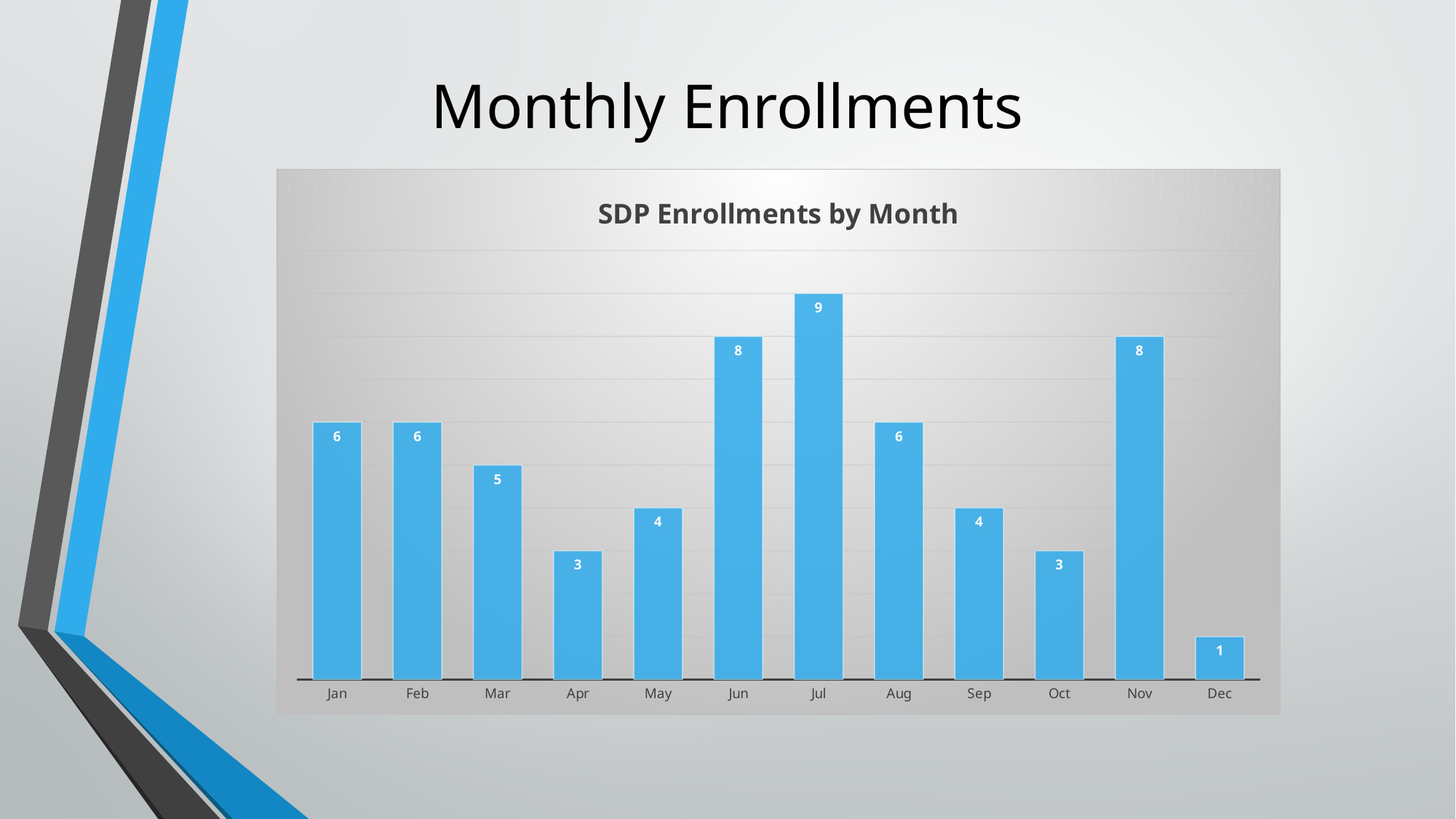
Which month has the lowest value? Dec How many months are shown on the x axis? 12 What is the difference between the values for Jul and Apr? 6 What is the difference between the values for Nov and Oct? 5 What kind of chart is this? bar chart Do the values rise or fall from Jan to Apr? fall What is the value for Dec? 1 Which is larger, the value for Jun or the value for Aug? Jun What is the value for Mar? 5 What is the value for Jul? 9 Which month has the highest value? Jul What is the title of the chart? SDP Enrollments by Month